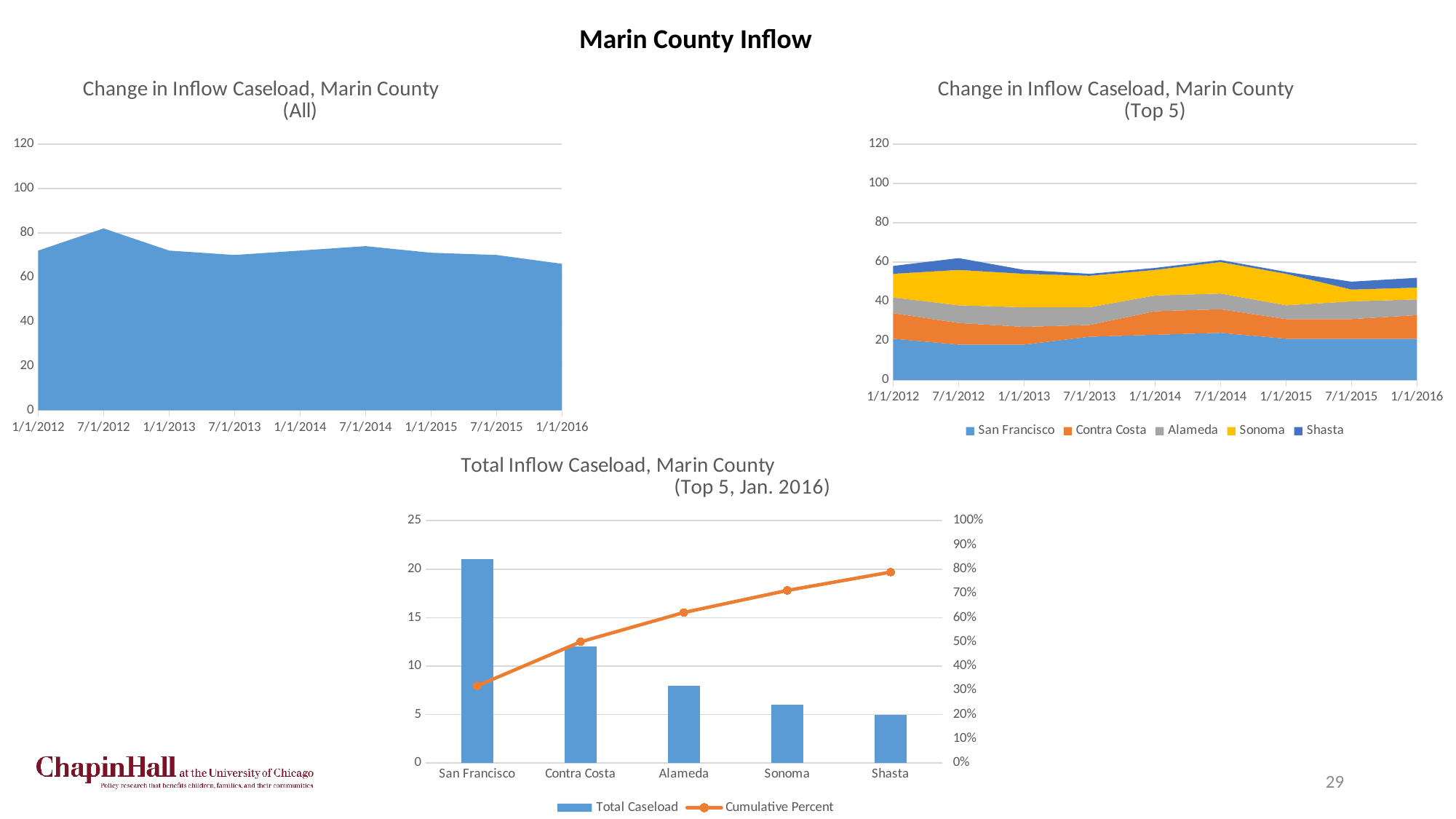
What kind of chart is the one titled 'Total Inflow Caseload, Marin County (Top 5, Jan. 2016)'? Bar chart with a line How many dates are shown on the x axis of the chart titled 'Change in Inflow Caseload, Marin County (All)'? 9 In the chart titled 'Total Inflow Caseload, Marin County (Top 5, Jan. 2016)', is the total caseload bar for Alameda greater or less than 10? less How many series does the legend list in the chart titled 'Total Inflow Caseload, Marin County (Top 5, Jan. 2016)'? 2 How many series does the legend list in the chart titled 'Change in Inflow Caseload, Marin County (Top 5)'? 5 In the chart titled 'Change in Inflow Caseload, Marin County (All)', is the value at 1/1/2016 greater or less than 80? less How many counties are shown on the x axis of the chart titled 'Total Inflow Caseload, Marin County (Top 5, Jan. 2016)'? 5 In the chart titled 'Total Inflow Caseload, Marin County (Top 5, Jan. 2016)', which county has the highest total caseload? San Francisco What kind of chart is the one titled 'Change in Inflow Caseload, Marin County (All)'? Area chart In the chart titled 'Total Inflow Caseload, Marin County (Top 5, Jan. 2016)', which has the larger total caseload, Contra Costa or Alameda? Contra Costa In the chart titled 'Total Inflow Caseload, Marin County (Top 5, Jan. 2016)', which county has the lowest total caseload? Shasta In the chart titled 'Total Inflow Caseload, Marin County (Top 5, Jan. 2016)', is the total caseload bar for San Francisco greater or less than 20? greater